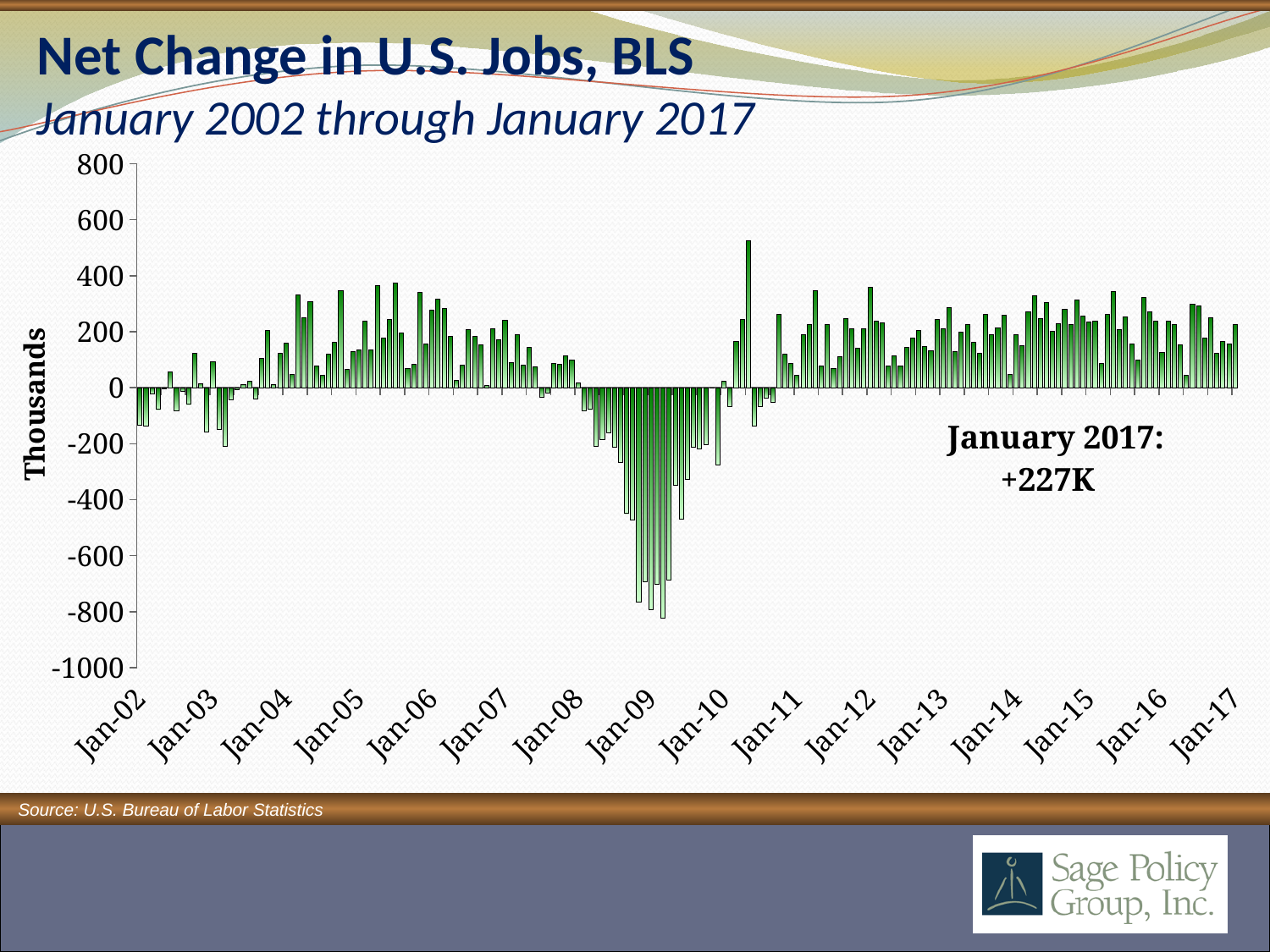
Is the value for January 2017 greater or less than 200? greater What is the title of the chart on the slide? Net Change in U.S. Jobs, BLS Is the highest bar on the chart greater or less than 400? greater What is the label on the vertical axis of the chart? Thousands In which year does the lowest bar on the chart occur? 2009 Is the lowest bar on the chart greater or less than -600? less What kind of chart is shown on the slide? Bar chart In which year does the highest bar on the chart occur? 2010 Do the values rise or fall from Jan-08 to Jan-09? fall Are the bars between Jan-09 and Jan-10 mostly positive or negative? negative What is the net change in U.S. jobs for January 2017 according to the annotation on the chart? +227K How many year labels (Jan-02 through Jan-17) are shown on the x axis? 16